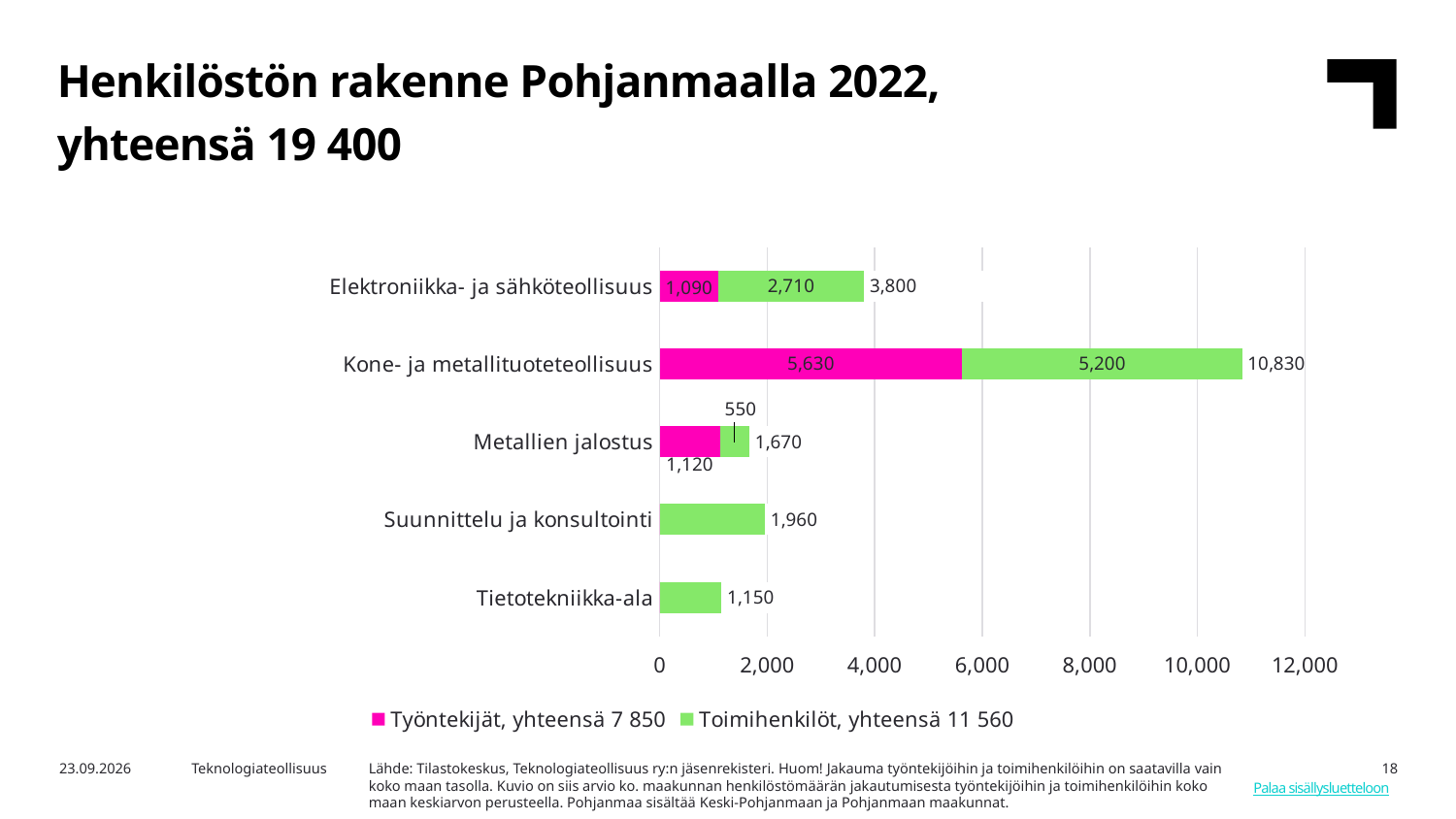
What total is given for Työntekijät in the legend? 7 850 What is the Toimihenkilöt value for Metallien jalostus? 550 What is the difference between the Työntekijät and Toimihenkilöt values for Kone- ja metallituoteteollisuus? 430 How many series does the legend list? 2 What is the Työntekijät value for Kone- ja metallituoteteollisuus? 5,630 Which category has the highest total? Kone- ja metallituoteteollisuus Which is larger: the total for Suunnittelu ja konsultointi or the total for Metallien jalostus? Suunnittelu ja konsultointi How many categories are shown on the chart? 5 What is the total for the Kone- ja metallituoteteollisuus bar? 10,830 Which category has the lowest total? Tietotekniikka-ala What is the Toimihenkilöt value for Elektroniikka- ja sähköteollisuus? 2,710 What type of chart is shown on the slide? Stacked bar chart